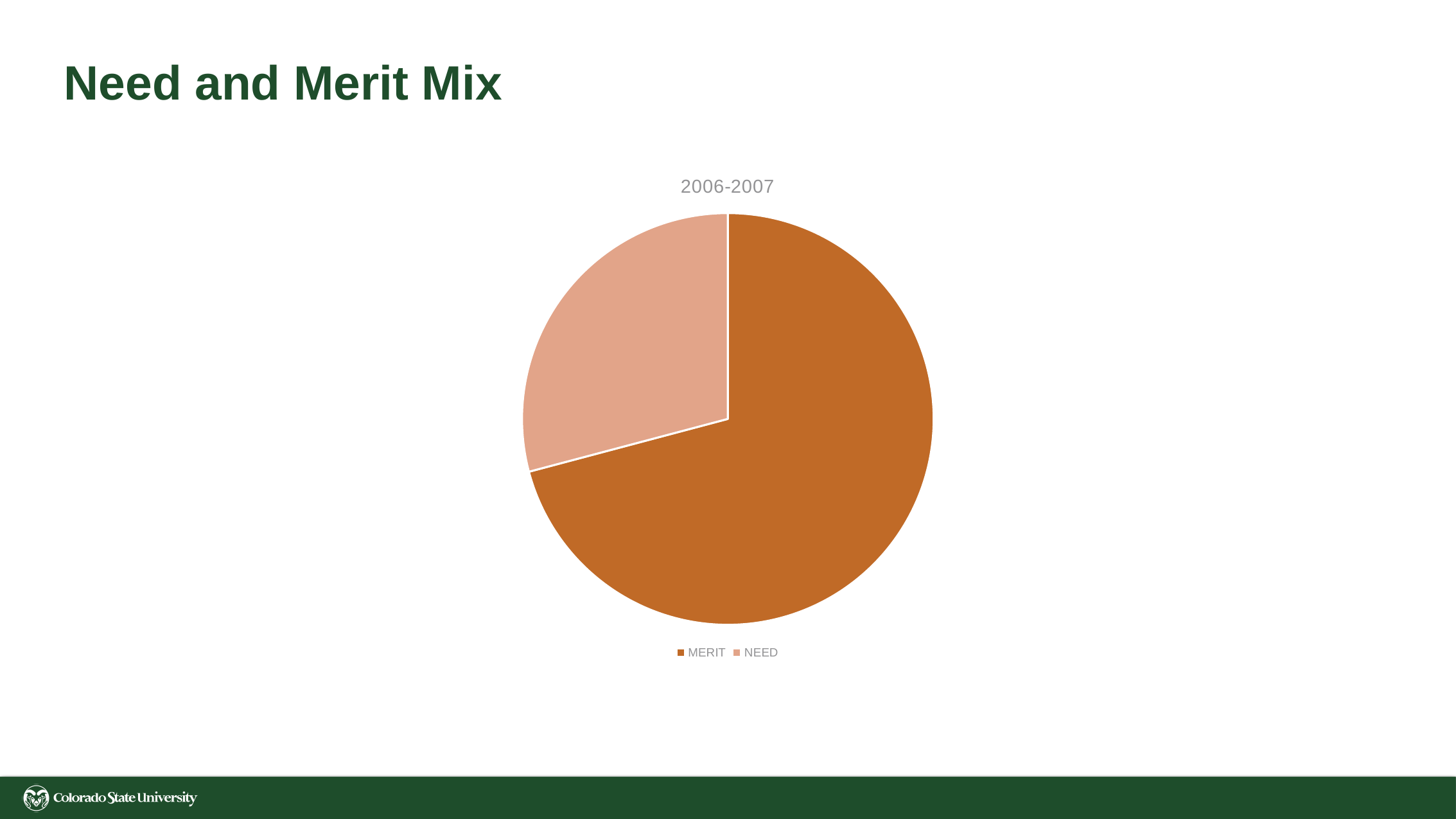
Does the NEED slice take up more or less than half of the pie? less Which slice is larger, MERIT or NEED? MERIT How many entries does the legend of the pie chart list? 2 What kind of chart is shown on the slide? pie chart How many slices does the pie chart have? 2 Which category has the largest slice of the pie chart? MERIT Which category is shown in the lighter, pale orange colour in the pie chart? NEED What is the title of the pie chart? 2006-2007 Which category has the smallest slice of the pie chart? NEED Does the MERIT slice take up more or less than half of the pie? more